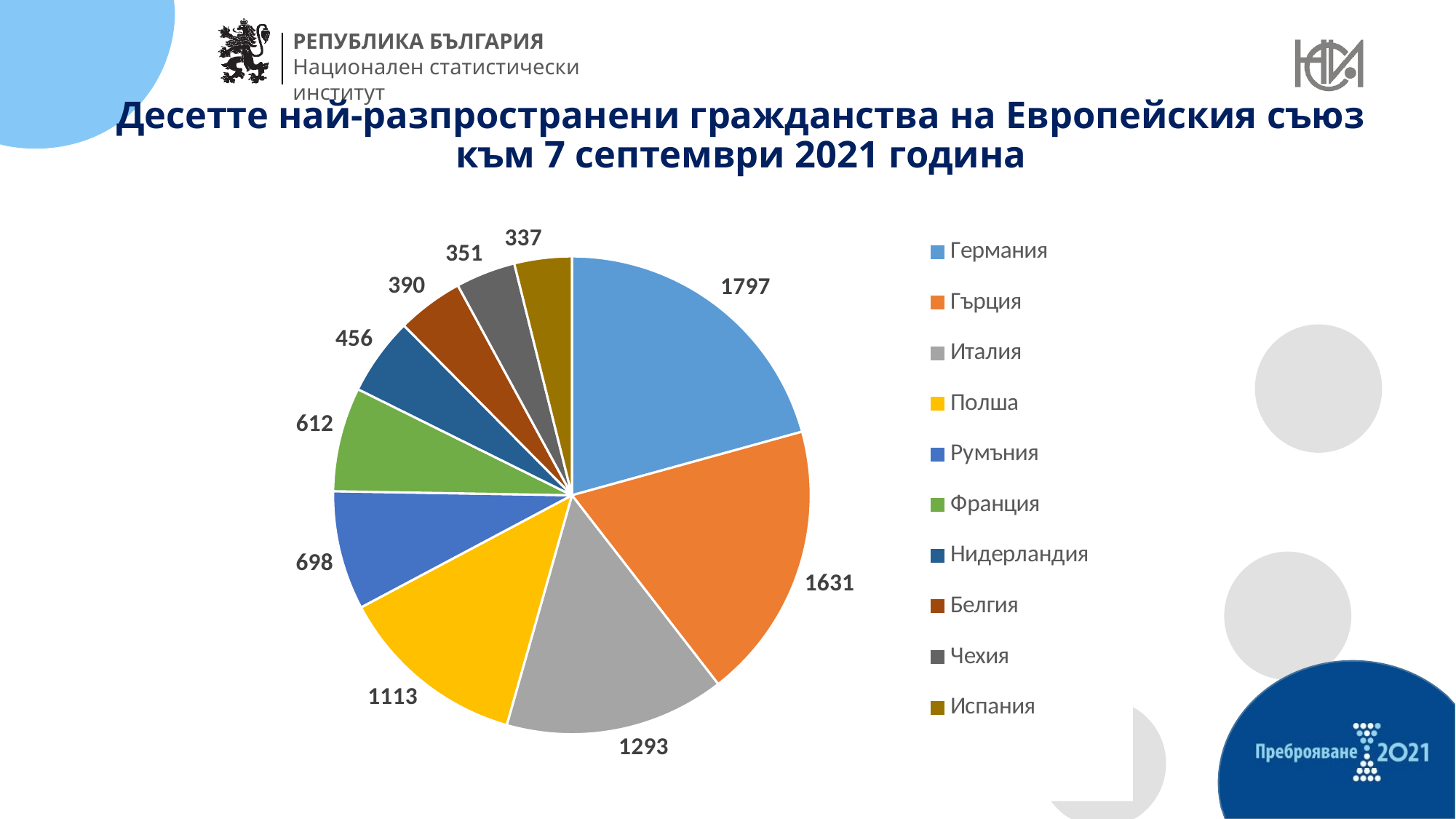
Which is larger, the value for Италия or the value for Полша? Италия Which category has the smallest slice? Испания What is the value for Полша? 1113 What is the value for Чехия? 351 How many categories does the pie chart have? 10 What is the value for Нидерландия? 456 What is the difference between the values for Германия and Гърция? 166 What is the difference between the values for Румъния and Франция? 86 How many entries does the legend list? 10 Which category has the largest slice? Германия What is the value for Германия? 1797 What kind of chart is shown on the slide? pie chart